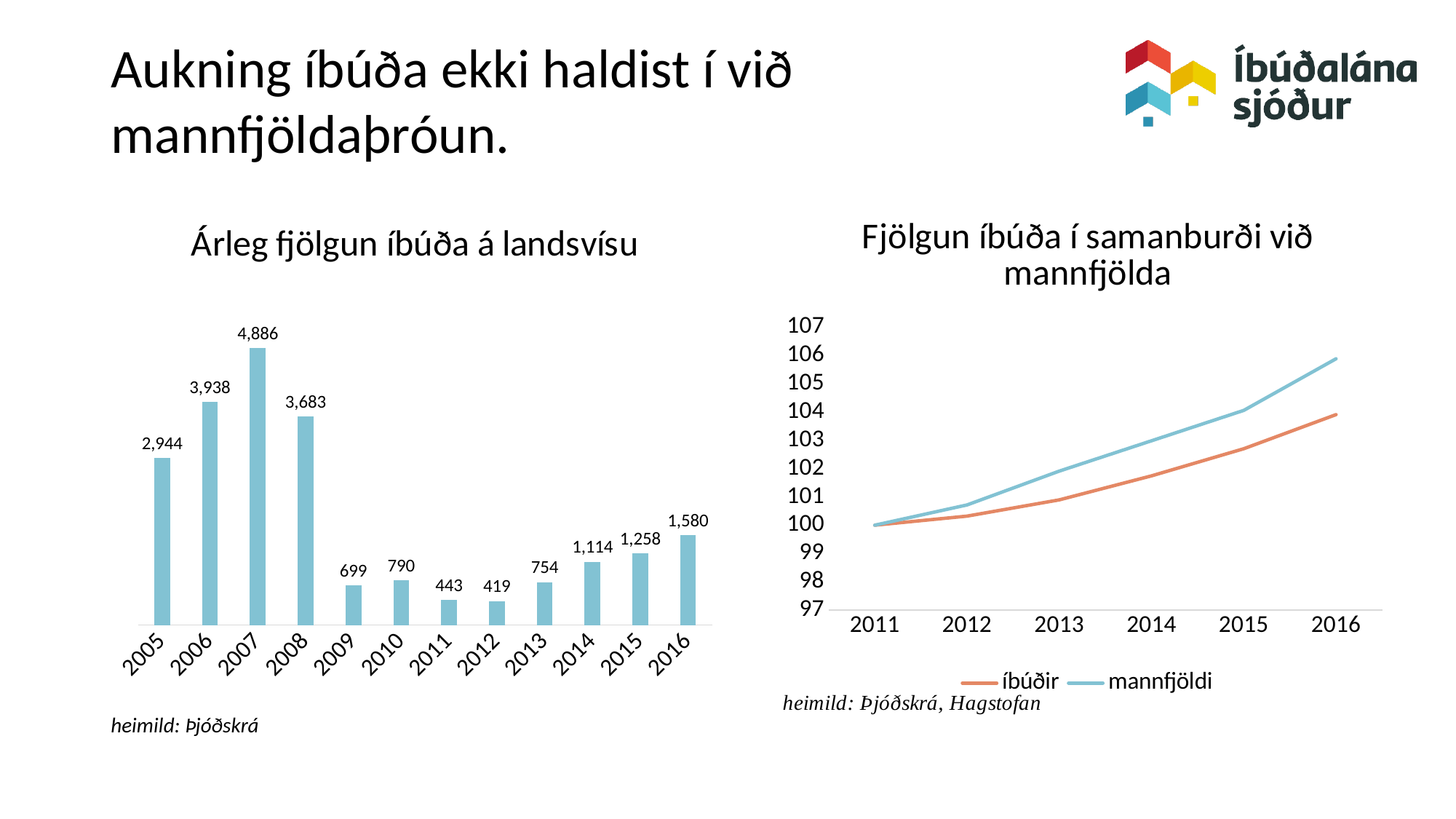
In the chart 'Árleg fjölgun íbúða á landsvísu', what is the difference between the values for 2016 and 2015? 322 In the chart 'Árleg fjölgun íbúða á landsvísu', what is the value for 2012? 419 In the chart 'Árleg fjölgun íbúða á landsvísu', which year has the lowest value? 2012 In the chart 'Fjölgun íbúða í samanburði við mannfjölda', is the value for mannfjöldi in 2016 greater or less than 105? greater In the chart 'Fjölgun íbúða í samanburði við mannfjölda', how many series does the legend list? 2 In the chart 'Fjölgun íbúða í samanburði við mannfjölda', do the values for íbúðir rise or fall from 2011 to 2016? Rise In the chart 'Árleg fjölgun íbúða á landsvísu', how many years are shown on the x axis? 12 In the chart 'Árleg fjölgun íbúða á landsvísu', what is the value for 2007? 4,886 What kind of chart is 'Árleg fjölgun íbúða á landsvísu'? Bar chart In the chart 'Fjölgun íbúða í samanburði við mannfjölda', which series is higher in 2015, íbúðir or mannfjöldi? mannfjöldi In the chart 'Árleg fjölgun íbúða á landsvísu', which is larger, the value for 2006 or the value for 2008? 2006 In the chart 'Árleg fjölgun íbúða á landsvísu', which year has the highest value? 2007